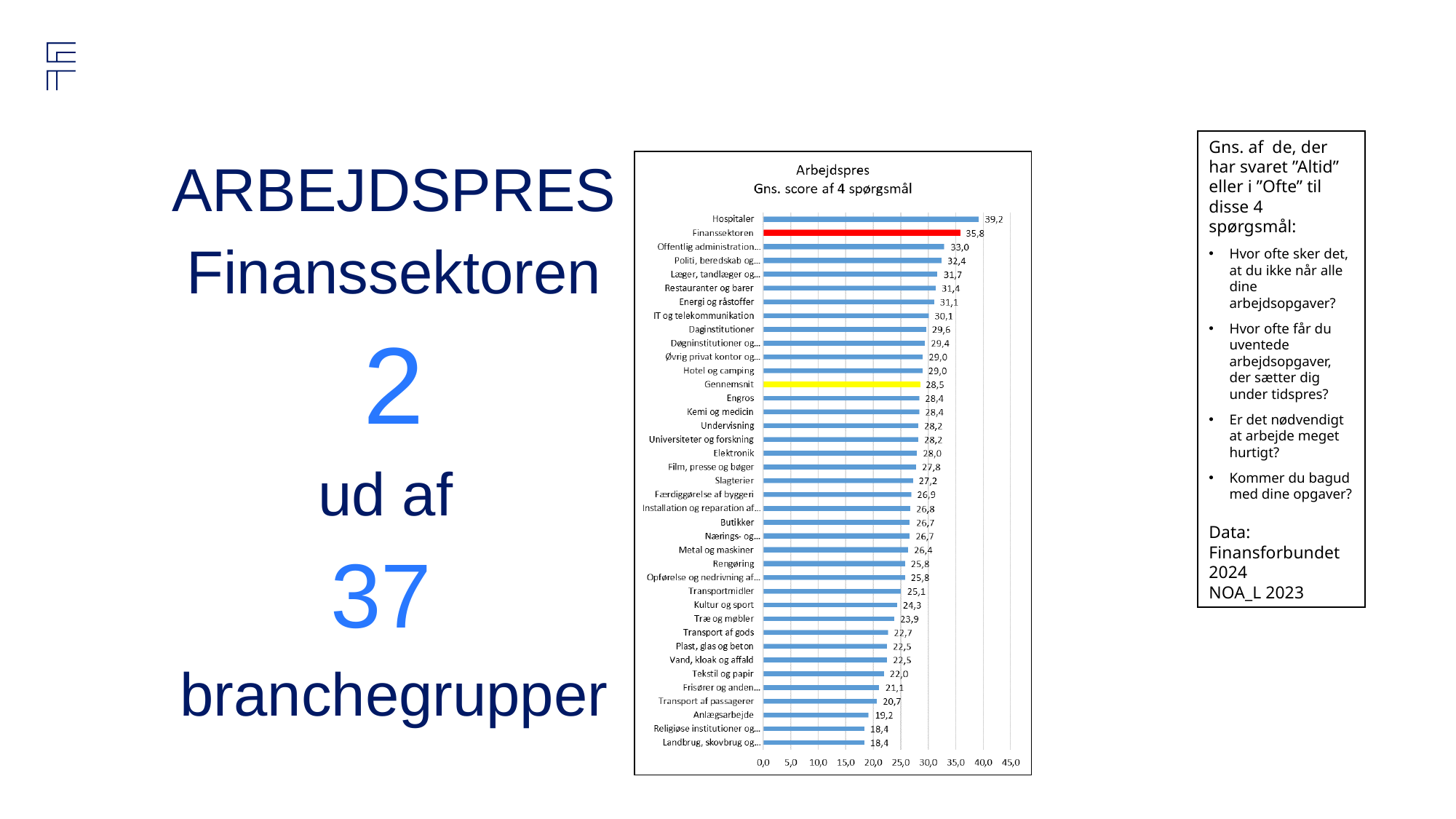
Which is larger, the value for IT og telekommunikation or the value for Daginstitutioner? IT og telekommunikation What is the value for Finanssektoren? 35,8 Which category has the highest value? Hospitaler Is the value for Anlægsarbejde greater or less than 20,0? less What is the value for Hospitaler? 39,2 What is the value for Transport af passagerer? 20,7 What is the value for Gennemsnit? 28,5 What kind of chart is shown? bar chart What is the value for Kultur og sport? 24,3 What is the difference between Hospitaler and Finanssektoren? 3,4 What colour is the bar for Finanssektoren? red What is the difference between Finanssektoren and Gennemsnit? 7,3